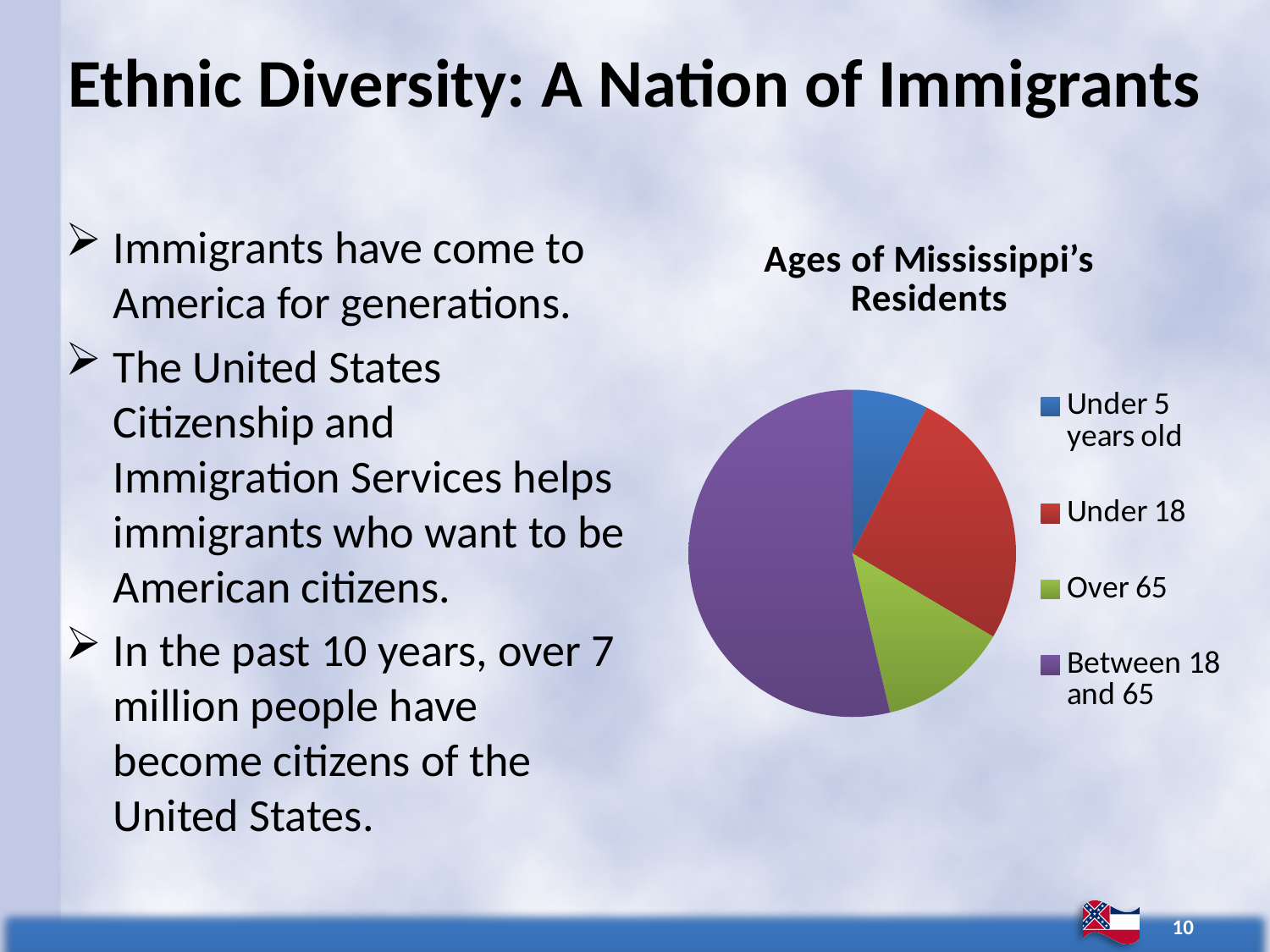
How many categories (slices) does the pie chart have? 4 What colour is the slice for Between 18 and 65? Purple Which age group has the smallest slice of the pie? Under 5 years old How many entries does the legend list? 4 Which slice is larger: Under 5 years old or Over 65? Over 65 Which age group has the largest slice of the pie? Between 18 and 65 What kind of chart is shown on the slide? Pie chart Which slice is larger: Under 18 or Over 65? Under 18 Which slice is larger: Between 18 and 65 or Under 18? Between 18 and 65 What is the title of the chart? Ages of Mississippi's Residents